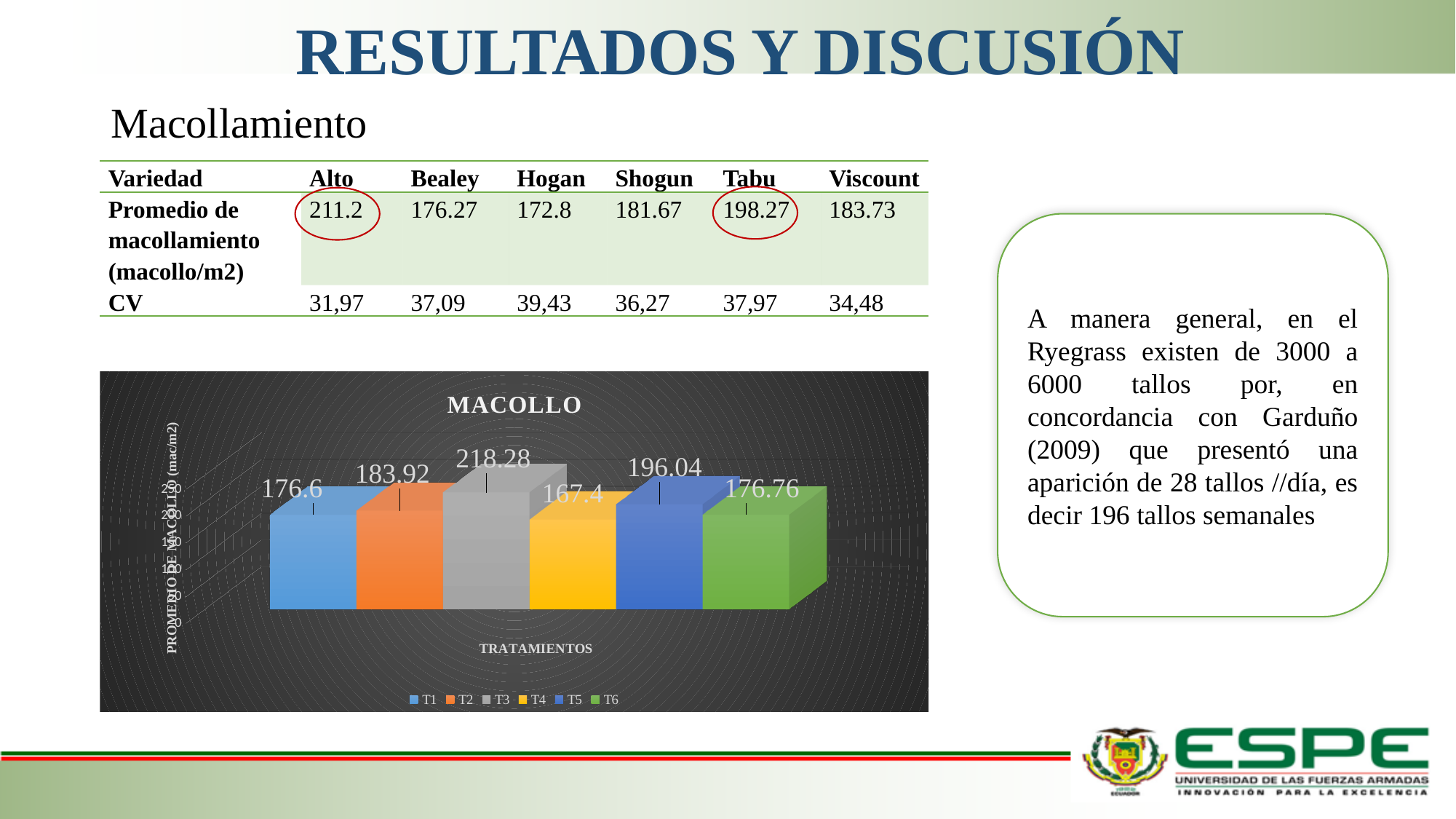
How many series does the legend of the MACOLLO chart list? 6 Which treatment has the lowest value in the MACOLLO chart? T4 What is the value shown for T3 in the MACOLLO chart? 218.28 In the MACOLLO chart, which is larger, the value for T2 or the value for T6? T2 What is the value shown for T5 in the MACOLLO chart? 196.04 What is the value shown for T1 in the MACOLLO chart? 176.6 What kind of chart is the MACOLLO chart? Bar chart How many bars are plotted in the MACOLLO chart? 6 What is the difference between the values for T3 and T4 in the MACOLLO chart? 50.88 What is the value shown for T4 in the MACOLLO chart? 167.4 Which treatment has the highest value in the MACOLLO chart? T3 What is the difference between the values for T5 and T2 in the MACOLLO chart? 12.12